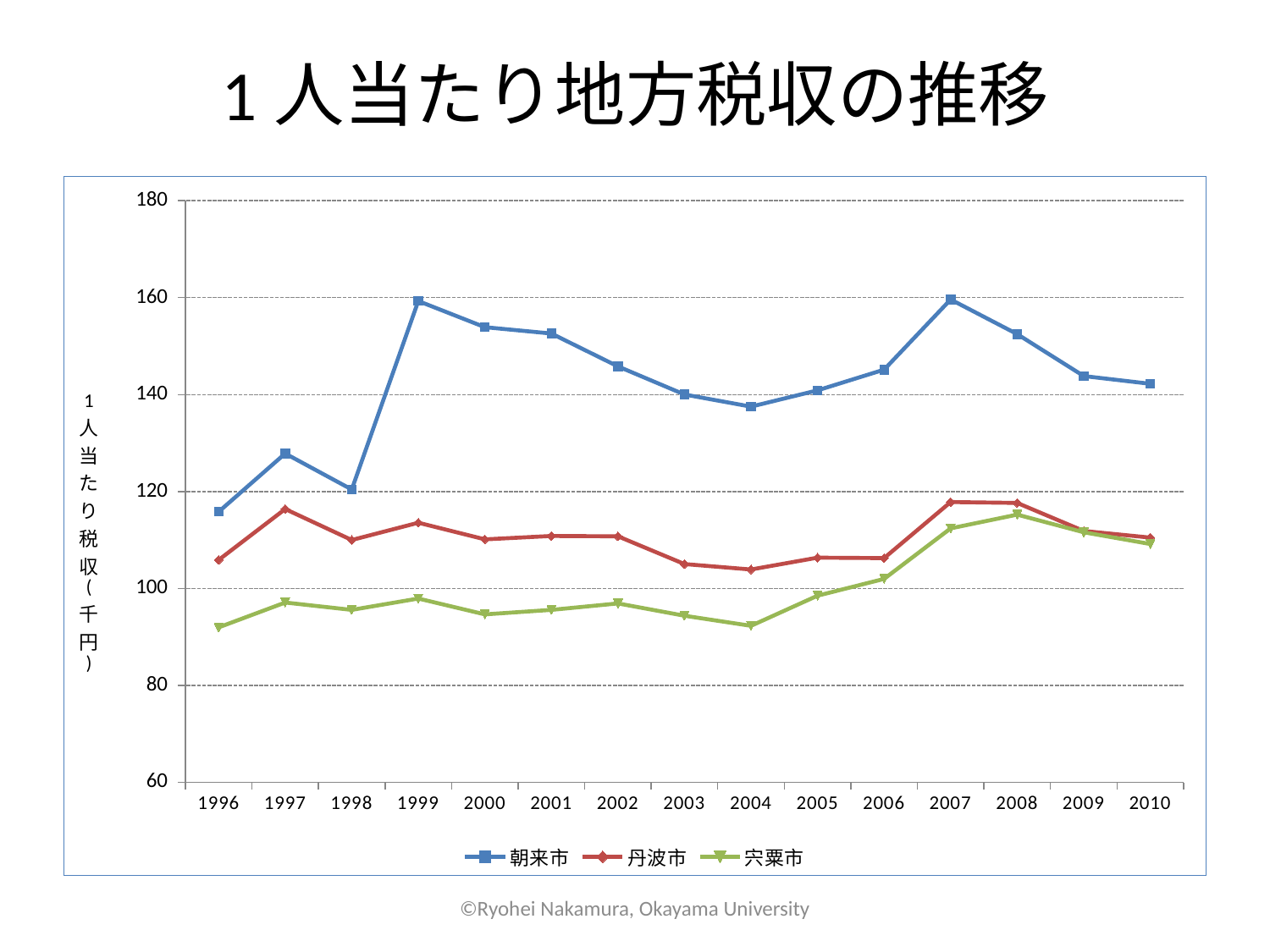
What is the title of the chart? １人当たり地方税収の推移 What kind of chart is shown on the slide? line chart Is the value for 朝来市 in 1999 greater or less than 140? greater In which year is the value for 朝来市 lowest? 1996 Is the value for 宍粟市 in 2004 greater or less than 100? less Does the value for 朝来市 rise or fall from 2007 to 2010? fall Is the value for 朝来市 in 2004 greater or less than 140? less How many series does the legend list? 3 Which series has the larger value in 2010, 朝来市 or 丹波市? 朝来市 How many years are plotted along the x axis? 15 In which year is the value for 宍粟市 highest? 2008